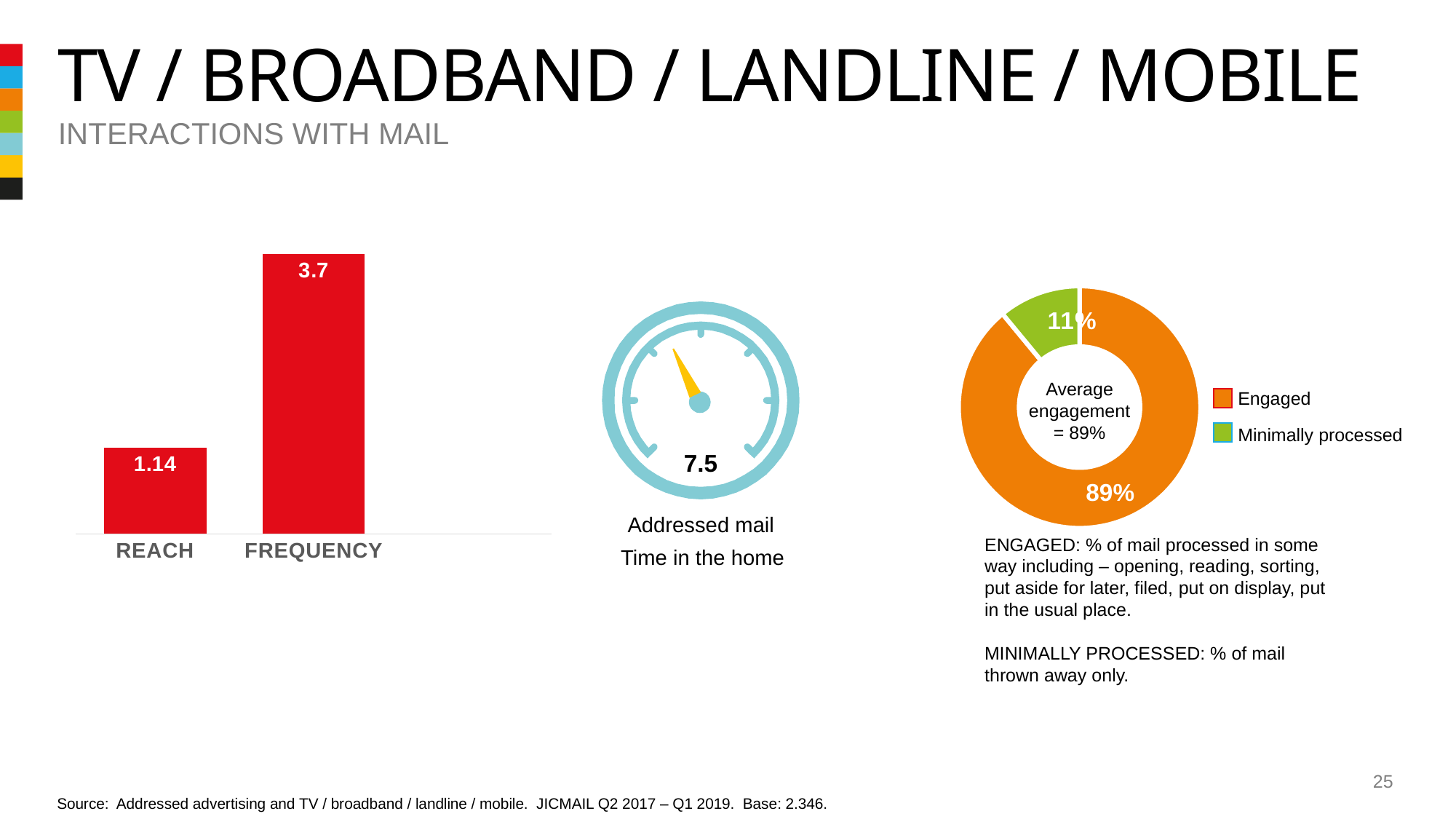
In the bar chart on the left, what is the difference between the FREQUENCY and REACH values? 2.56 What value is shown on the gauge in the middle of the slide for addressed mail time in the home? 7.5 What kind of chart is shown on the left of the slide? Bar chart In the bar chart on the left, how many categories are shown? 2 In the bar chart on the left, what is the value for REACH? 1.14 In the donut chart on the right, which slice is larger, Engaged or Minimally processed? Engaged In the bar chart on the left, which category has the higher value? FREQUENCY How many entries does the legend of the donut chart on the right list? 2 In the bar chart on the left, what is the value for FREQUENCY? 3.7 In the donut chart on the right, what share is labelled Engaged? 89% In the bar chart on the left, which category has the lower value? REACH In the donut chart on the right, what share is labelled Minimally processed? 11%